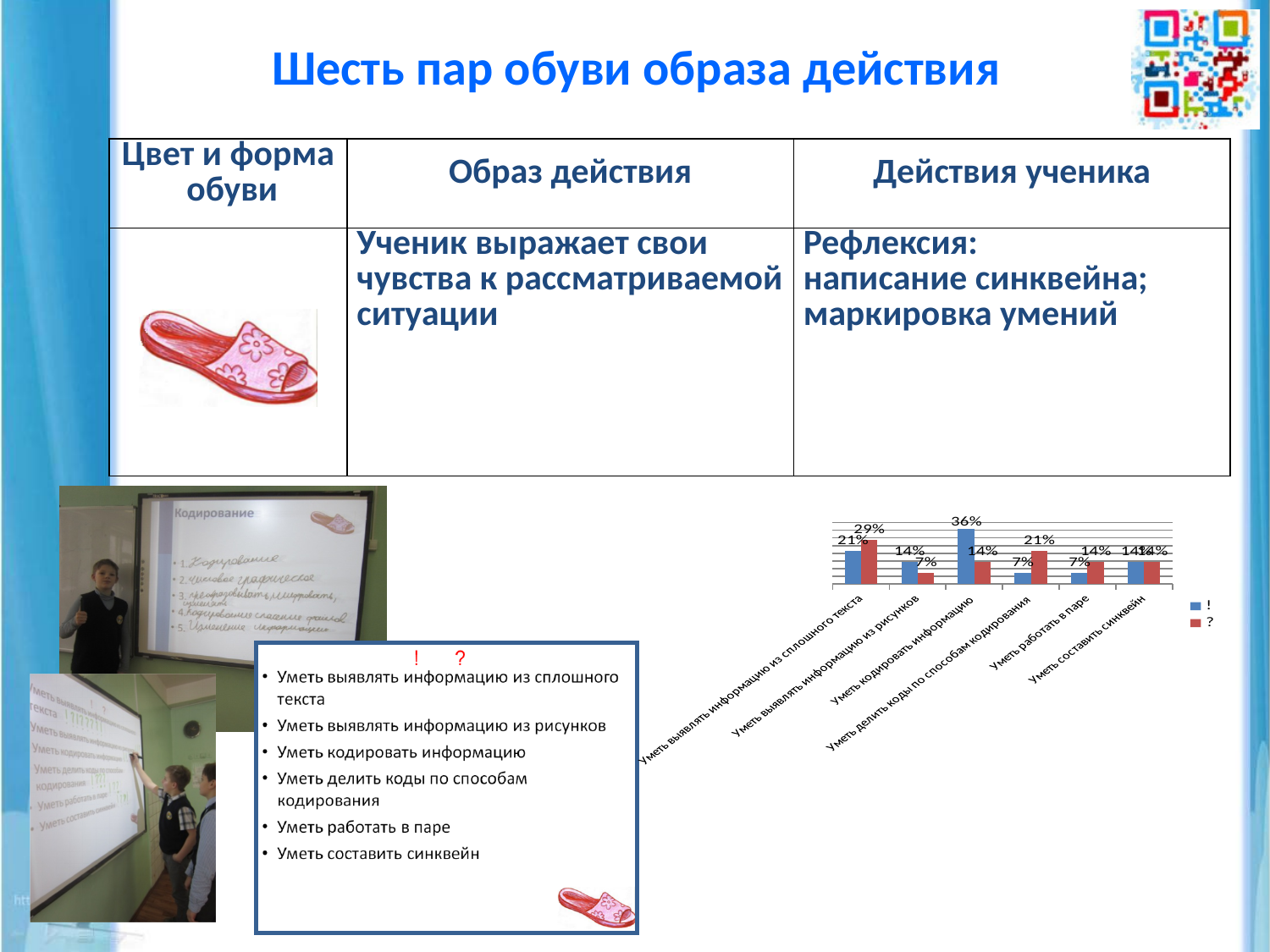
What are the two legend entries of the chart? ! and ? What is the value of the "?" series for "Уметь выявлять информацию из сплошного текста"? 29% What is the value of the "?" series for "Уметь работать в паре"? 14% How many series does the chart legend list? 2 What is the value of the "!" series for "Уметь кодировать информацию"? 36% What is the value of the "!" series for "Уметь делить коды по способам кодирования"? 7% Which category has the highest value in the "!" series? Уметь кодировать информацию Which category has the highest value in the "?" series? Уметь выявлять информацию из сплошного текста For "Уметь выявлять информацию из рисунков", which series has the larger value, "!" or "?"? ! What is the difference between the "!" and "?" values for "Уметь кодировать информацию"? 22% How many categories are plotted on the chart? 6 What kind of chart is shown on the slide? bar chart